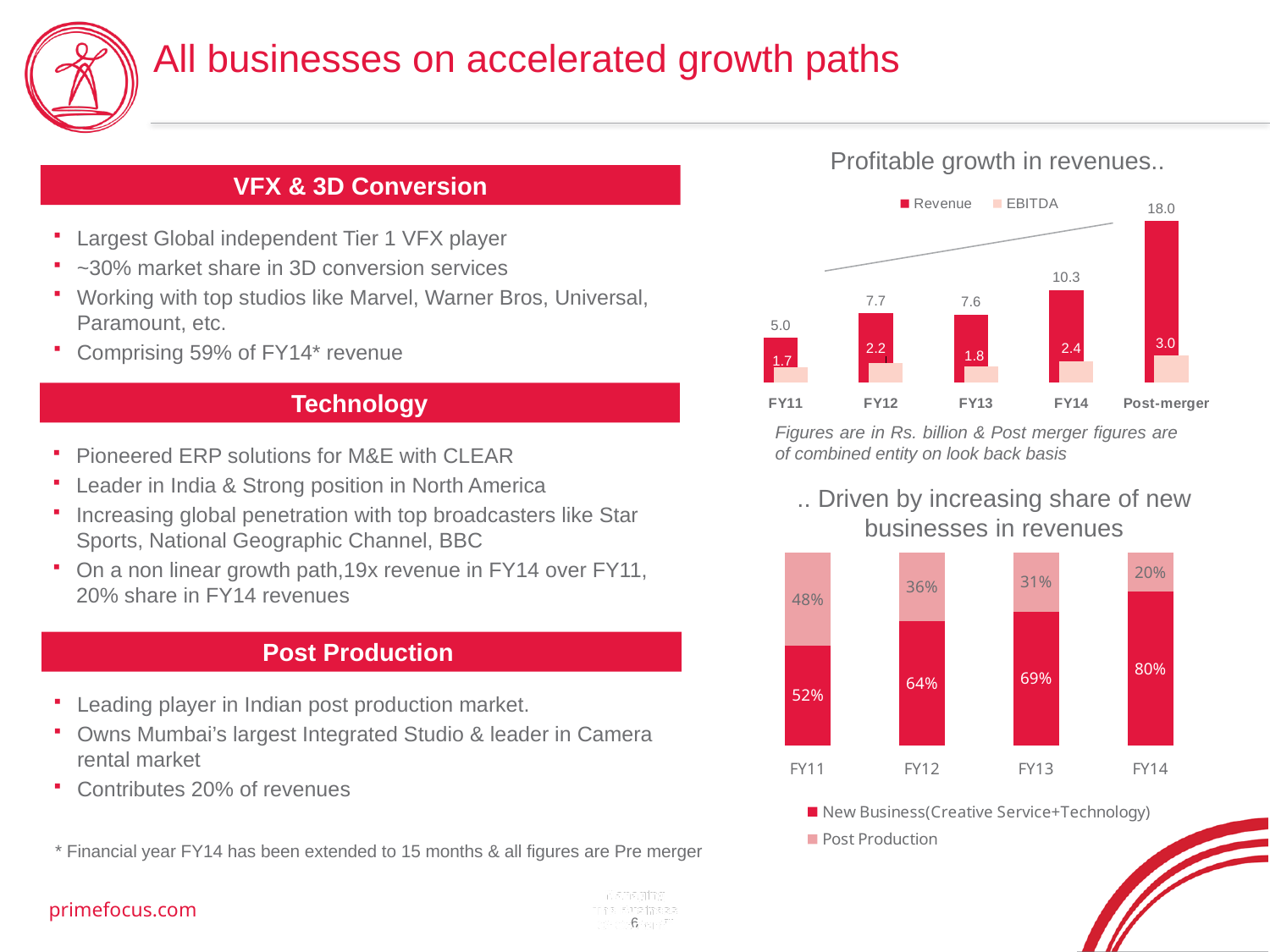
In the 'Profitable growth in revenues..' chart, how many categories are shown on the x axis? 5 In the '.. Driven by increasing share of new businesses in revenues' chart, what is the New Business share for FY13? 69% In the '.. Driven by increasing share of new businesses in revenues' chart, what is the Post Production share for FY11? 48% In the 'Profitable growth in revenues..' chart, what is the Revenue value for FY14? 10.3 In the 'Profitable growth in revenues..' chart, is the Revenue for FY12 or FY13 larger? FY12 In the 'Profitable growth in revenues..' chart, which category has the lowest EBITDA? FY11 In the '.. Driven by increasing share of new businesses in revenues' chart, does the New Business share rise or fall from FY11 to FY14? rise In the 'Profitable growth in revenues..' chart, how many series does the legend list? 2 In the 'Profitable growth in revenues..' chart, what is the difference between the Post-merger Revenue and the FY14 Revenue? 7.7 In the 'Profitable growth in revenues..' chart, what is the EBITDA value for FY13? 1.8 In the 'Profitable growth in revenues..' chart, which category has the highest Revenue? Post-merger What kind of chart is the '.. Driven by increasing share of new businesses in revenues' chart? stacked bar chart